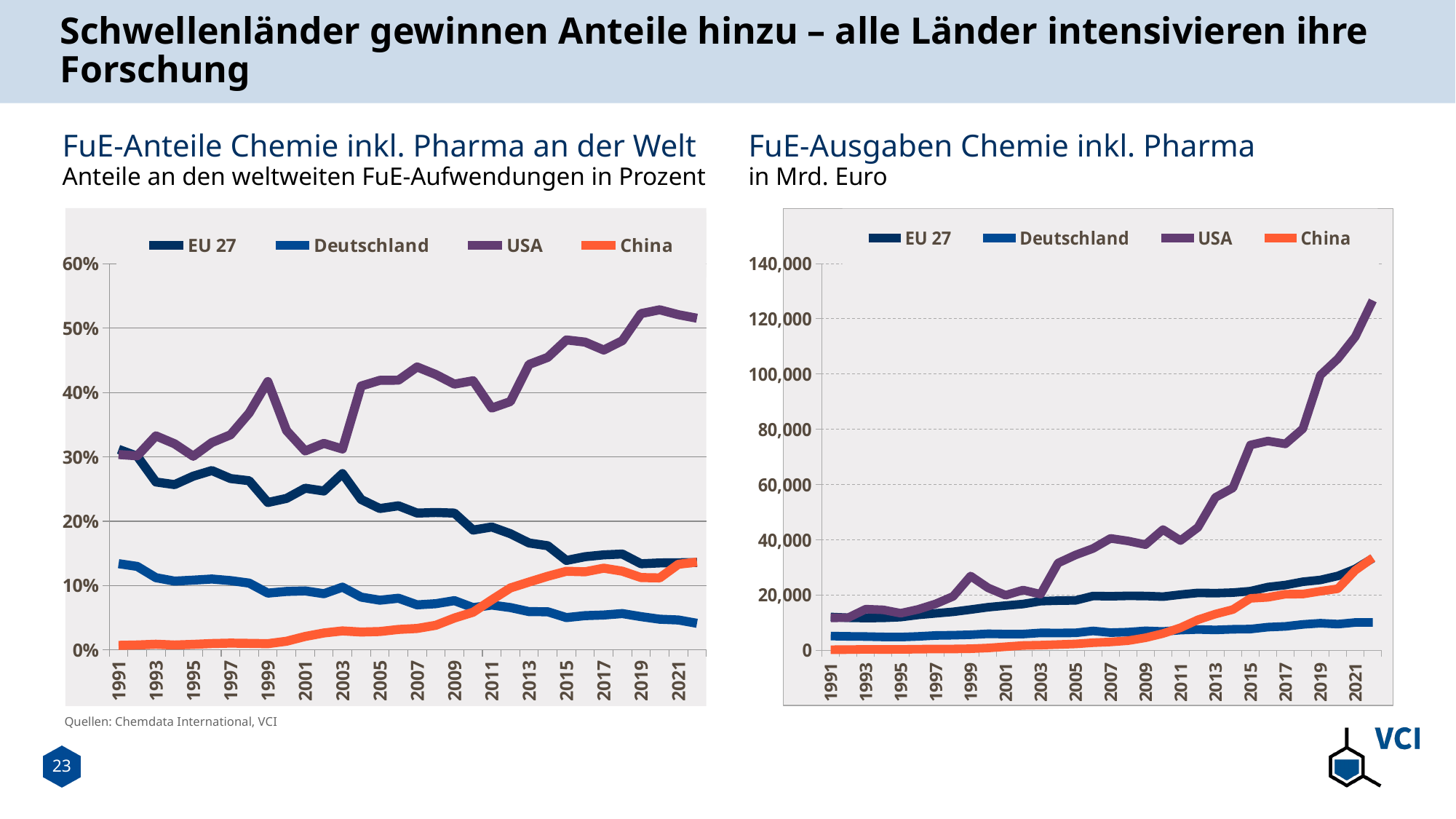
In the left chart, 'FuE-Anteile Chemie inkl. Pharma an der Welt', is the value for China in 1991 greater or less than 10%? less How many series does the legend of the right chart, 'FuE-Ausgaben Chemie inkl. Pharma', list? 4 In the left chart, 'FuE-Anteile Chemie inkl. Pharma an der Welt', which series has the lowest value in 2021? Deutschland In the left chart, 'FuE-Anteile Chemie inkl. Pharma an der Welt', which series has the highest value in 2021? USA In the right chart, 'FuE-Ausgaben Chemie inkl. Pharma', is the value for USA in 2021 greater or less than 100,000? greater In the left chart, 'FuE-Anteile Chemie inkl. Pharma an der Welt', is the value for USA in 2021 greater or less than 50%? greater In the right chart, 'FuE-Ausgaben Chemie inkl. Pharma', which is larger in 2021: USA or Deutschland? USA In the left chart, 'FuE-Anteile Chemie inkl. Pharma an der Welt', does the EU 27 line rise or fall from 1991 to 2021? fall In the right chart, 'FuE-Ausgaben Chemie inkl. Pharma', which series has the lowest value in 2021? Deutschland What kind of chart is the left chart, 'FuE-Anteile Chemie inkl. Pharma an der Welt'? line chart What unit is given in the subtitle of the right chart, 'FuE-Ausgaben Chemie inkl. Pharma'? in Mrd. Euro In the left chart, 'FuE-Anteile Chemie inkl. Pharma an der Welt', does the China line rise or fall from 1991 to 2021? rise